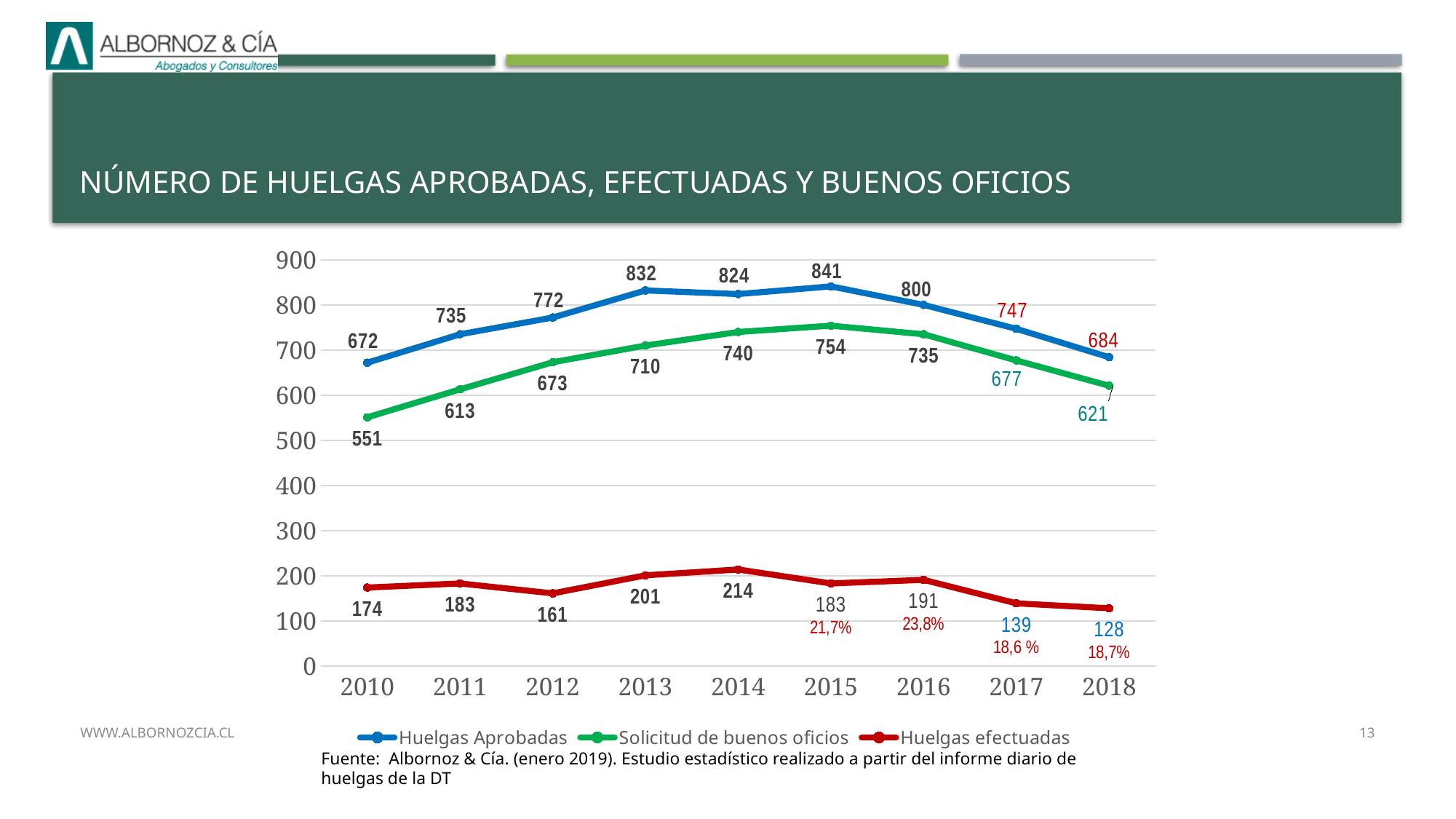
What is the difference between Huelgas Aprobadas and Solicitud de buenos oficios in 2018? 63 What is the value of Solicitud de buenos oficios in 2010? 551 Does Solicitud de buenos oficios rise or fall from 2010 to 2015? Rise What colour is the line for Huelgas efectuadas? Red How many series does the legend list? 3 What kind of chart is shown on the slide? Line chart What is the value of Huelgas efectuadas in 2014? 214 In which year is Huelgas Aprobadas highest? 2015 Which is larger in 2012: Huelgas Aprobadas or Solicitud de buenos oficios? Huelgas Aprobadas In which year is Huelgas efectuadas lowest? 2018 How many years are shown on the x axis? 9 What is the value of Huelgas Aprobadas in 2015? 841